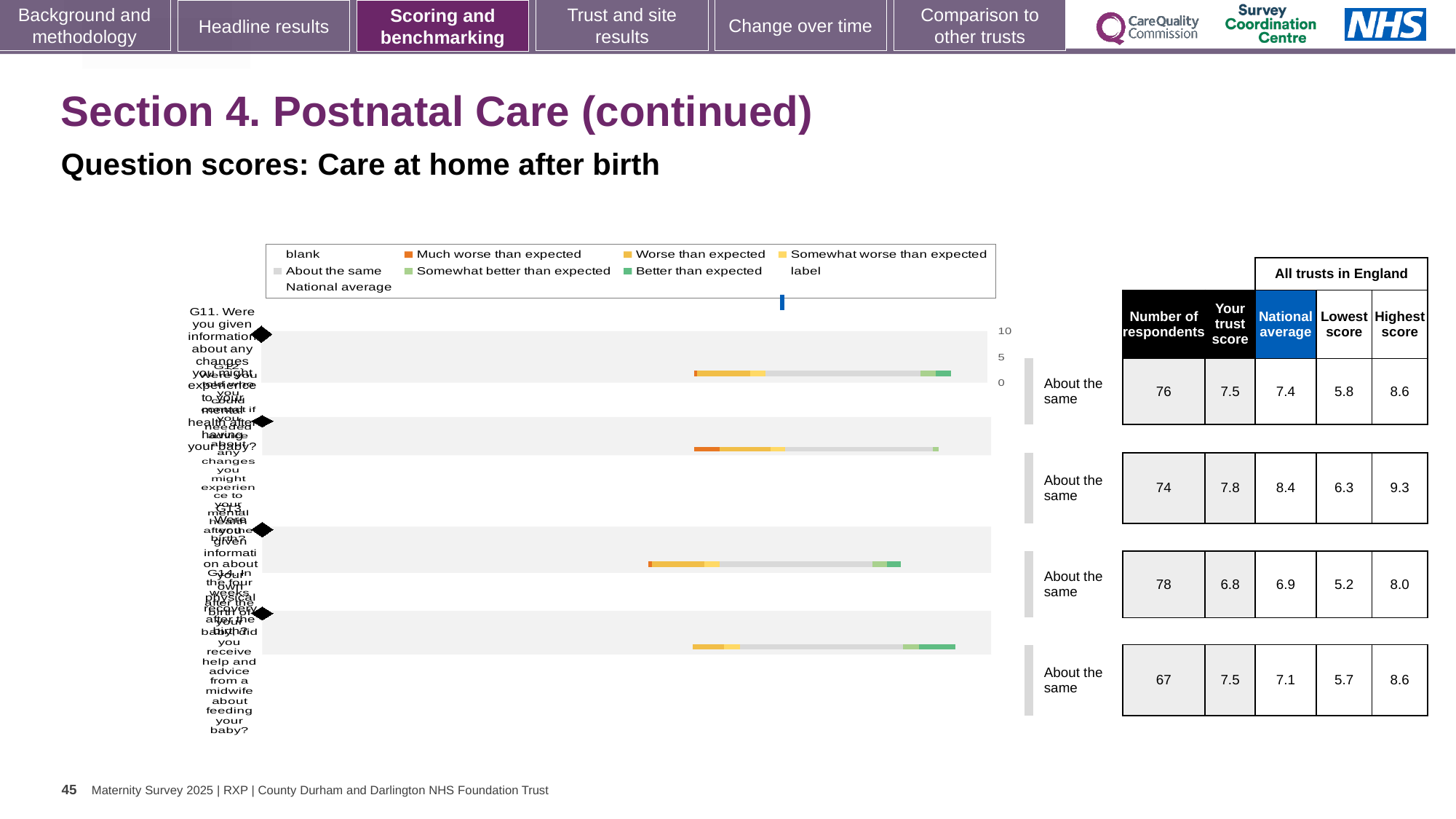
In the table to the right of the chart, what is the highest score for the third row? 8.0 In the chart legend, what colour represents 'Much worse than expected'? orange In the table to the right of the chart, what is 'Your trust score' for the second row? 7.8 How many horizontal bars (question rows) does the chart contain? 4 In the table to the right of the chart, what is the lowest score for the fourth row? 5.7 In the table to the right of the chart, which row has the highest 'Your trust score'? the second row (7.8) In the table to the right of the chart, for the first row, which is larger: 'Your trust score' or the national average? Your trust score In the table to the right of the chart, what is the difference between the national average and 'Your trust score' in the second row? 0.6 What kind of chart is shown on the slide? bar chart In the chart legend, which category is shown in light grey? About the same In the table to the right of the chart, what is the number of respondents for the first row? 76 What benchmark label is shown next to each of the four bars in the chart? About the same